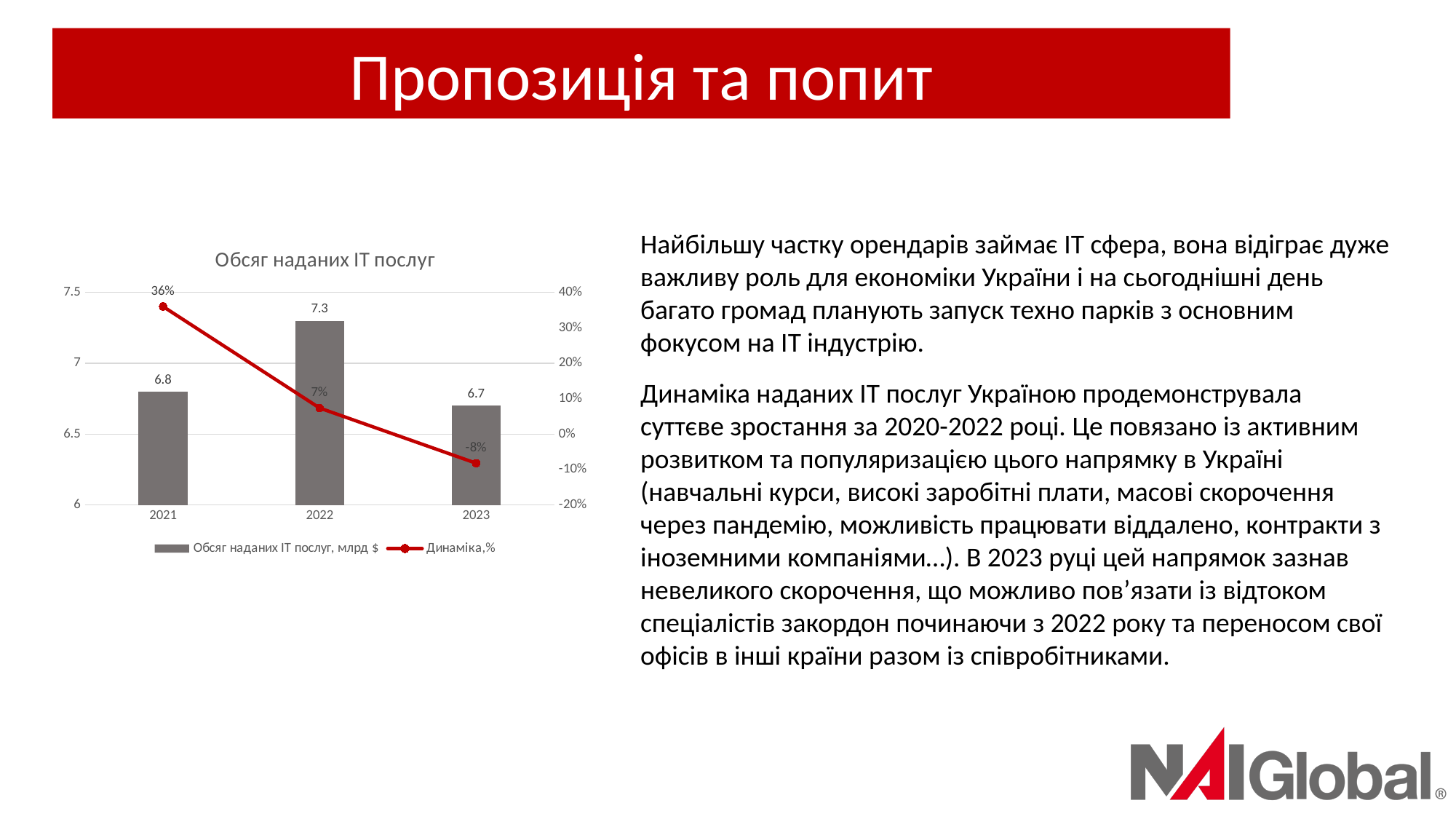
Does the 'Динаміка,%' line rise or fall from 2021 to 2023? fall What is the value of the bar for 2022 in the chart? 7.3 What is the value of the bar for 2021 in the chart? 6.8 Which is larger, the bar value for 2021 or for 2023? 2021 What is the value of the 'Динаміка,%' line for 2023? -8% Which year has the lowest 'Динаміка,%' value? 2023 Which year has the highest bar value in the chart? 2022 What is the value of the bar for 2023 in the chart? 6.7 How many years are shown on the x axis of the chart? 3 What is the difference between the bar values for 2022 and 2021? 0.5 What is the value of the 'Динаміка,%' line for 2021? 36% How many series does the chart legend list? 2